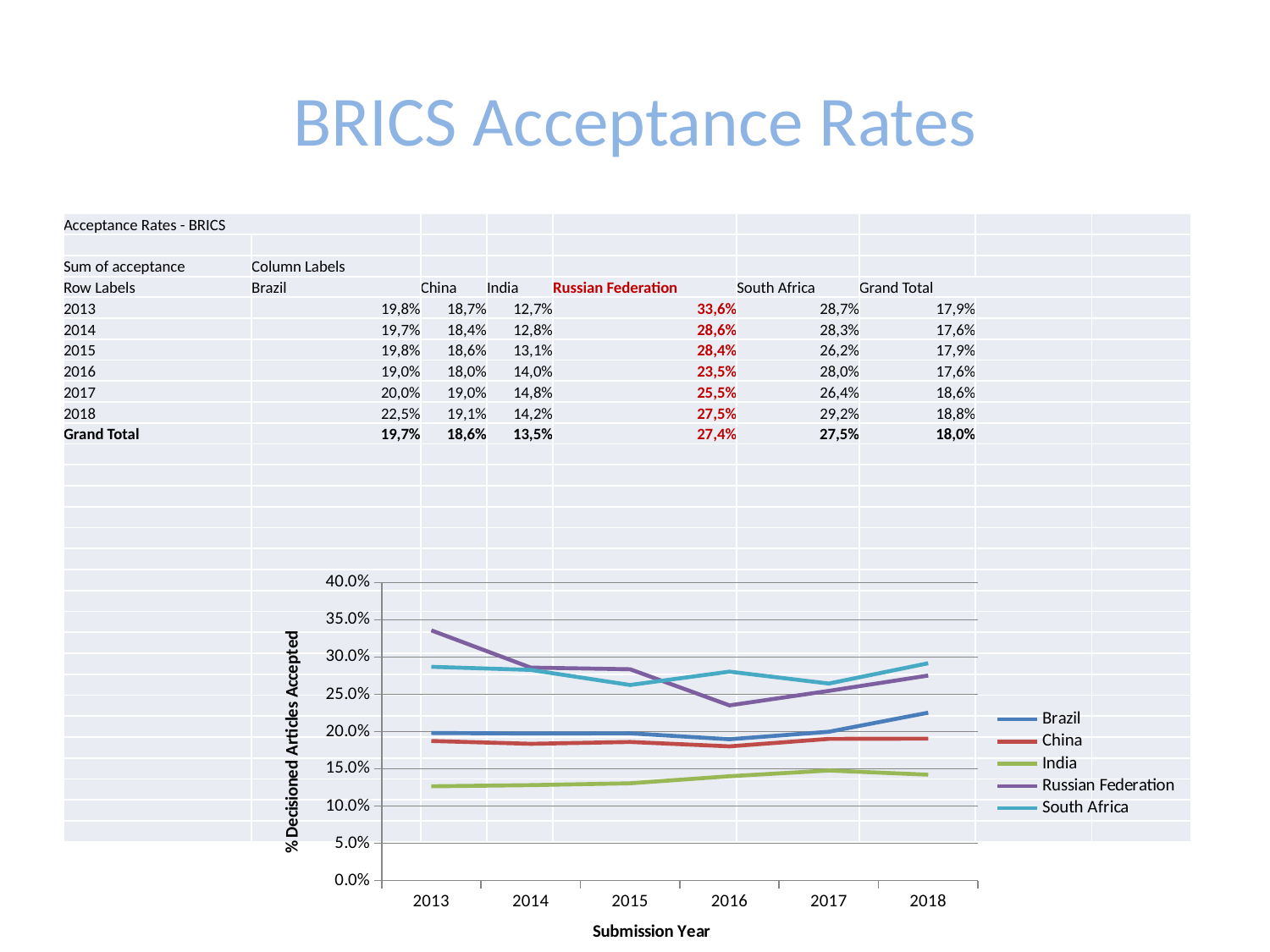
Which country had the lowest acceptance rate in 2018? India Does India's acceptance rate rise or fall from 2013 to 2017 on the chart? rise What kind of chart is shown on the slide? line chart How many submission years are plotted along the x axis of the chart? 6 In 2016, which had the higher acceptance rate, South Africa or the Russian Federation? South Africa On the chart, is the value for the Russian Federation in 2013 greater or less than 30.0%? greater Using the table values, by how many percentage points did Brazil's acceptance rate increase from 2013 (19,8%) to 2018 (22,5%)? 2,7 According to the table, what was the acceptance rate for the Russian Federation in 2013? 33,6% What is the title of the chart's vertical axis? % Decisioned Articles Accepted How many series does the chart legend list? 5 Which country had the highest acceptance rate in 2013? Russian Federation According to the table, what is the Grand Total acceptance rate for China? 18,6%